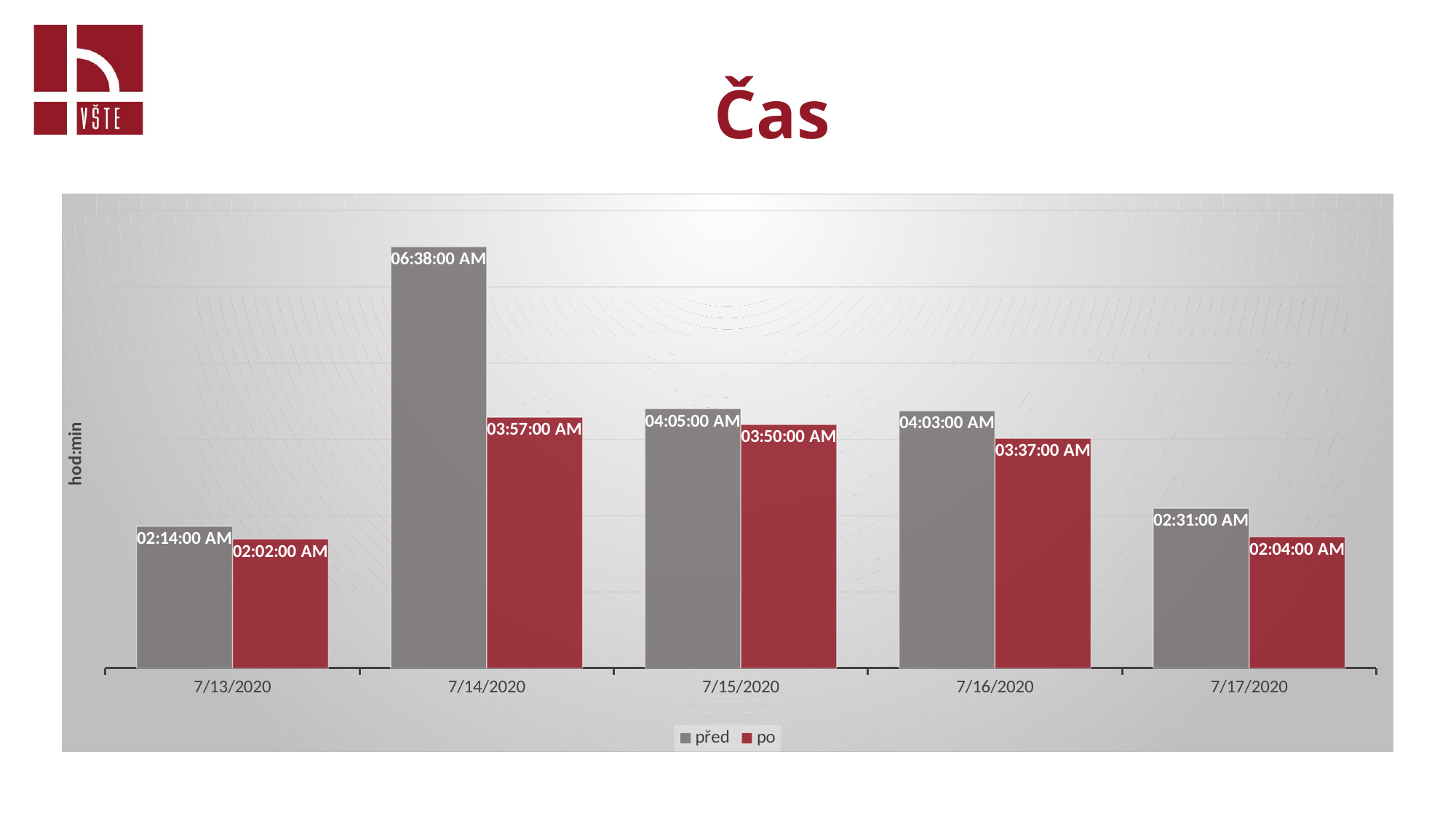
What is the label on the vertical axis? hod:min On which date is the "před" value highest? 7/14/2020 What is the value for "po" on 7/16/2020? 03:37:00 AM How many series does the legend list? 2 What is the value for "po" on 7/13/2020? 02:02:00 AM What is the difference between the "před" and "po" values on 7/13/2020? 12 minutes What kind of chart is shown on the slide? bar chart What is the value for "před" on 7/17/2020? 02:31:00 AM On which date is the "po" value lowest? 7/13/2020 Which is larger on 7/15/2020, the "před" value or the "po" value? před What is the value for "před" on 7/14/2020? 06:38:00 AM How many dates are shown on the x axis? 5